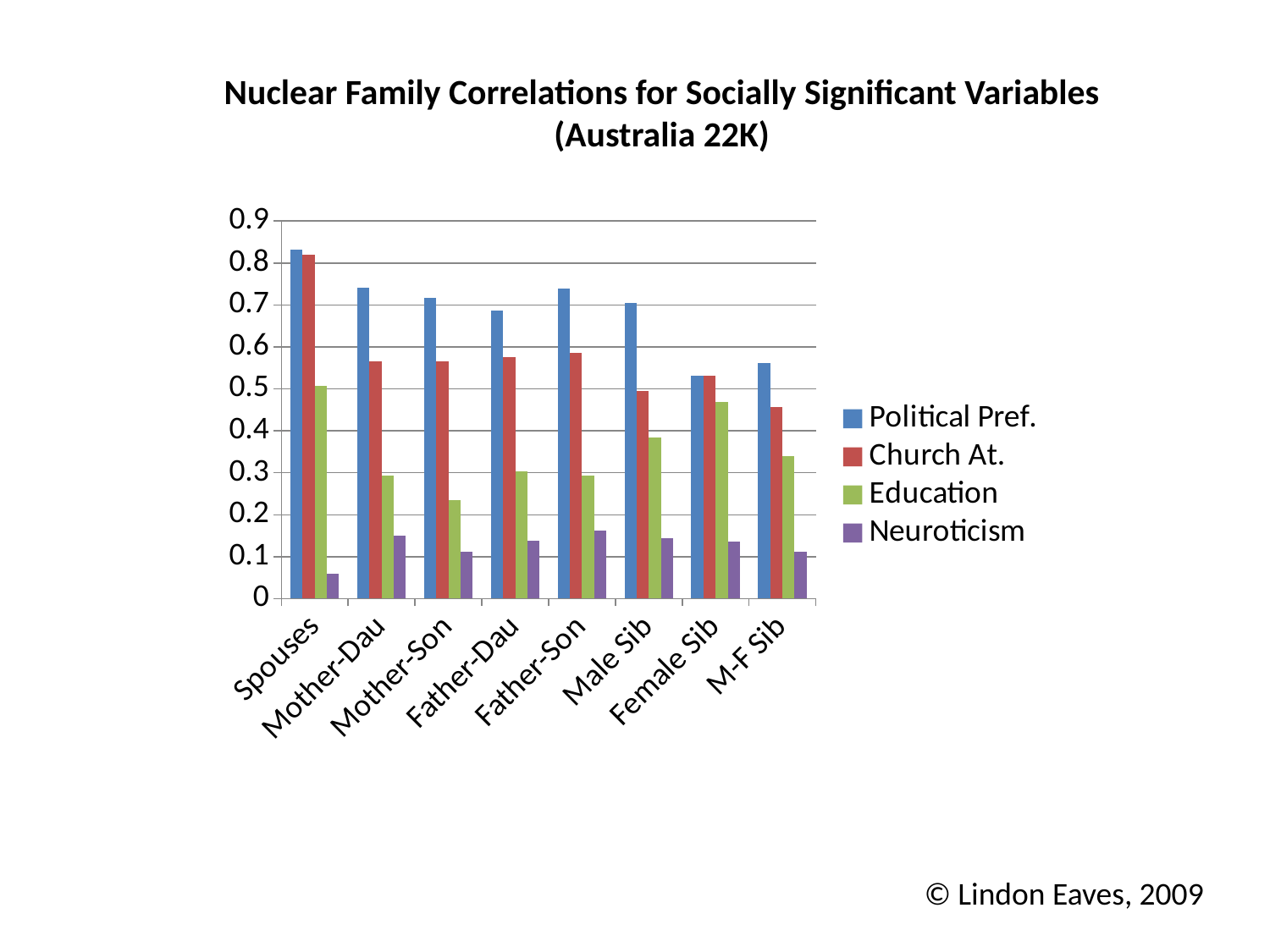
Which category has the lowest Education correlation? Mother-Son How many series does the legend list? 4 Is the Church At. value for M-F Sib greater or less than 0.5? less Is the Neuroticism value for Spouses greater or less than 0.1? less For Male Sib, which is larger: the Political Pref. value or the Education value? Political Pref. What kind of chart is shown on the slide? Bar chart Is the Political Pref. value for Spouses greater or less than 0.8? greater How many family relationship categories are shown on the x axis? 8 Which series is shown in green in the legend? Education Which category has the highest Political Pref. correlation? Spouses Which category has the lowest Neuroticism correlation? Spouses